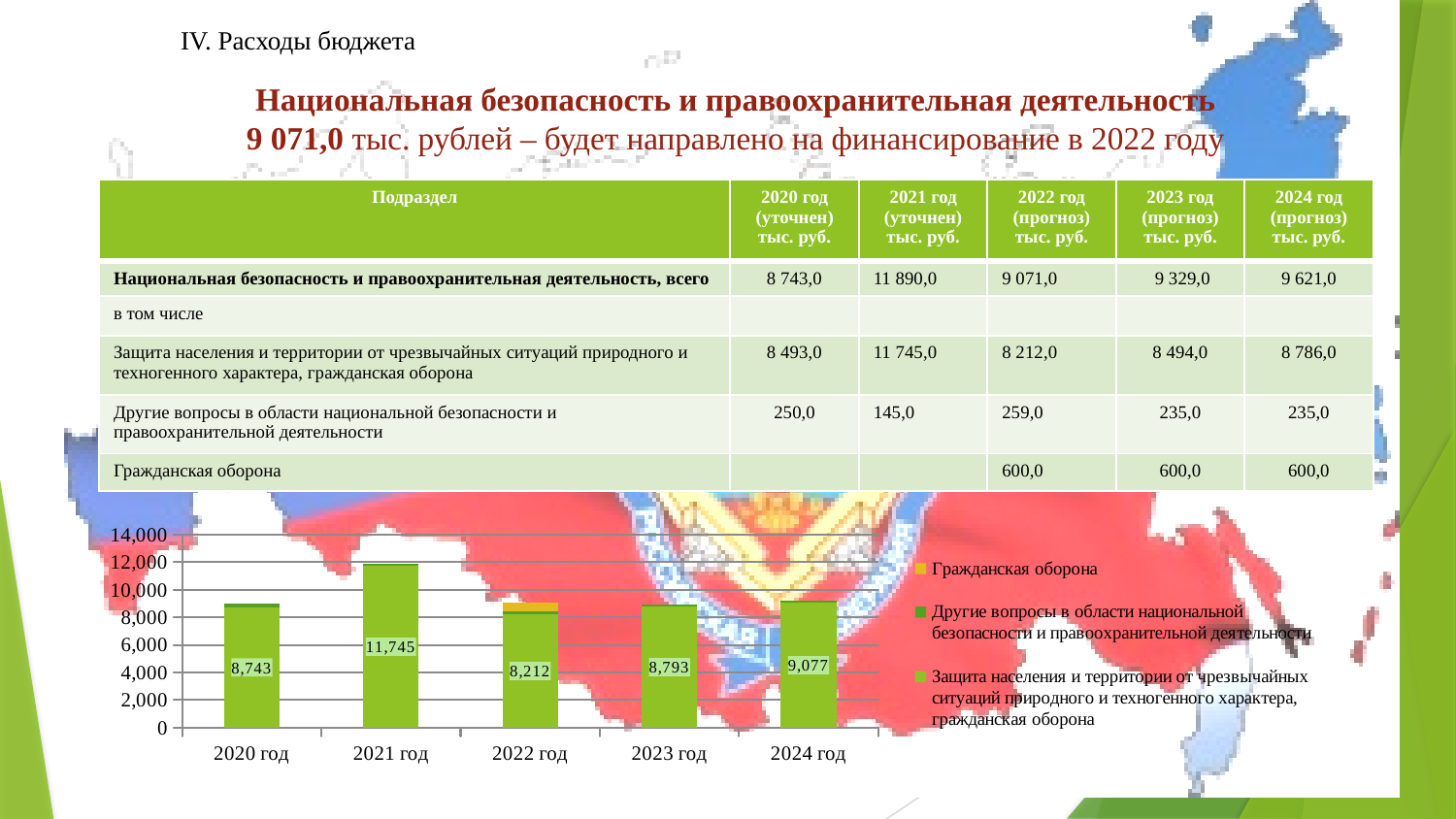
Which year has the highest labelled value in the chart? 2021 год Which legend entry is shown in orange in the chart? Гражданская оборона What value is printed on the bar for 2024 год in the chart? 9,077 What is the difference between the labelled values for 2021 год and 2022 год in the chart? 3,533 How many year categories are shown on the x axis of the chart? 5 How many series does the chart legend list? 3 What value is printed on the bar for 2022 год in the chart? 8,212 Which has the larger labelled value in the chart, 2023 год or 2024 год? 2024 год What value is printed on the bar for 2021 год in the chart? 11,745 Is the total height of the 2021 год bar greater or less than 10,000? greater What kind of chart is shown at the bottom of the slide? bar chart Which year has the lowest labelled value in the chart? 2022 год